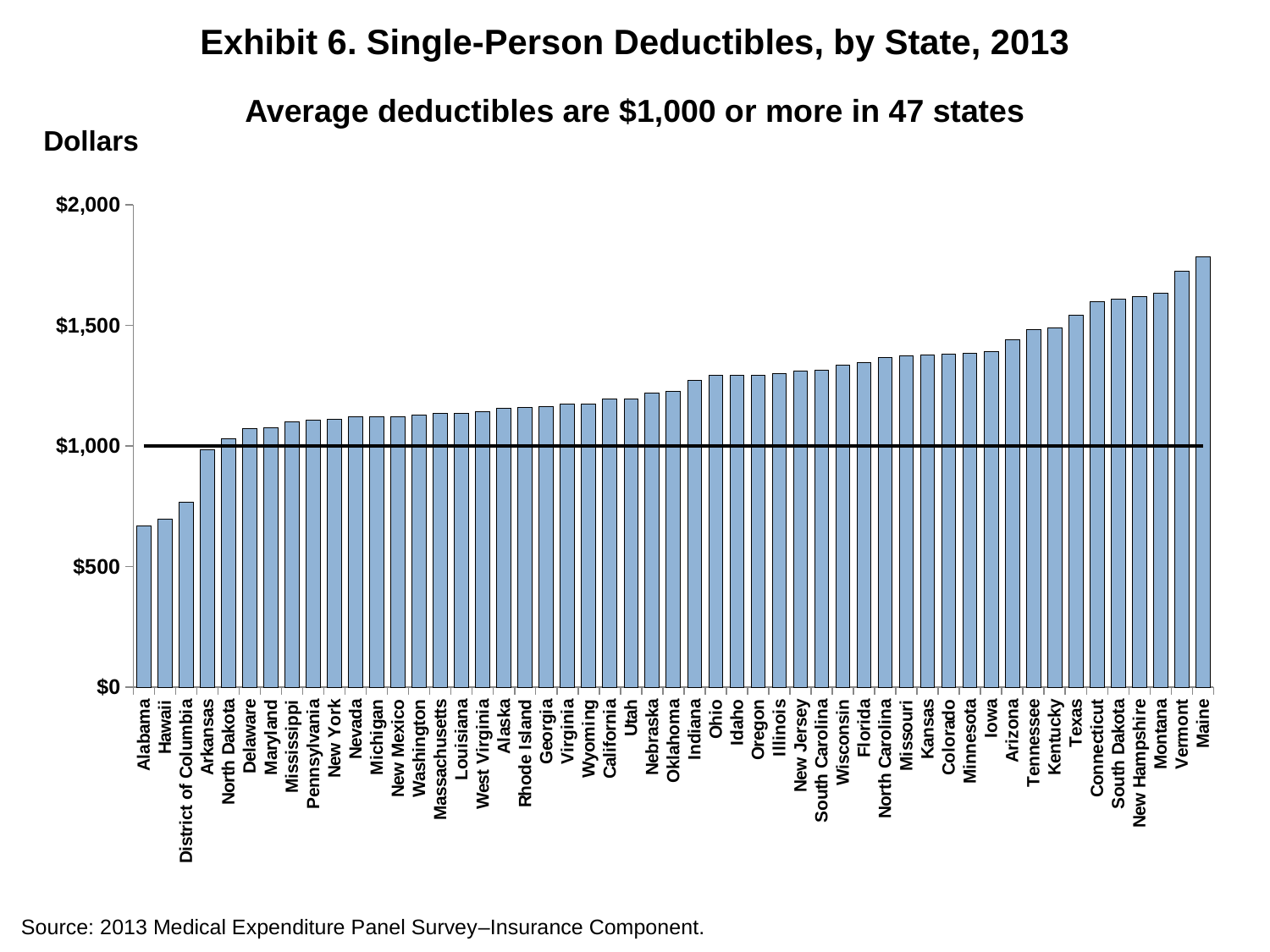
What kind of chart is shown on the slide? bar chart Which state has the highest single-person deductible? Maine Is the value for Vermont greater or less than $2,000? less Which state has the lowest single-person deductible? Alabama Is the value for Alabama greater or less than $1,000? less Which has the larger deductible, Texas or Delaware? Texas Is the value for Hawaii greater or less than $500? greater Do the values rise or fall moving from left to right along the x axis? rise How many states (including the District of Columbia) are plotted on the chart? 51 At what dollar value is the horizontal reference line drawn across the chart? $1,000